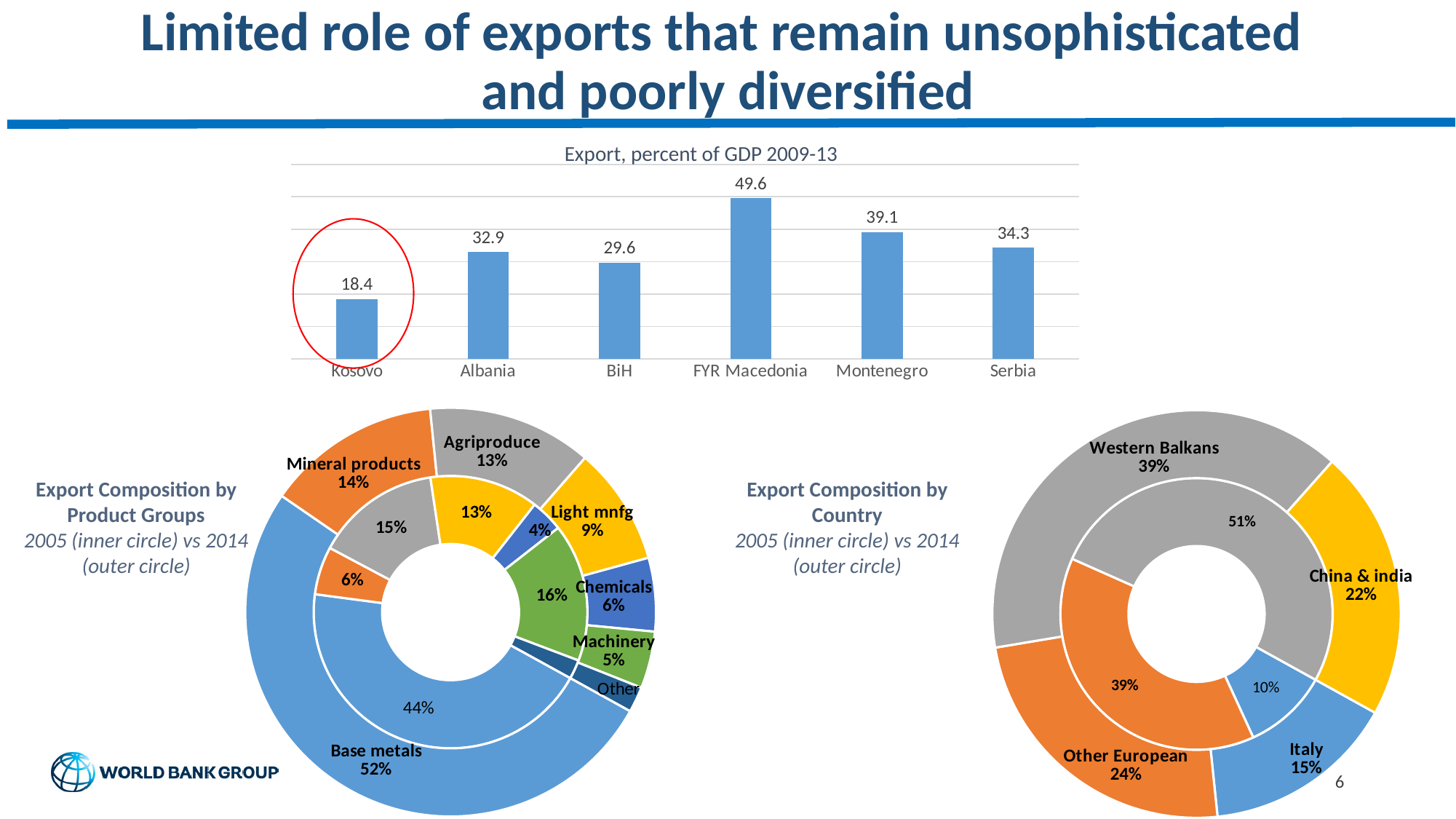
In the bar chart 'Export, percent of GDP 2009-13', what is the value for Kosovo? 18.4 In the 'Export Composition by Product Groups' chart, what share of the outer circle (2014) is Base metals? 52% How many countries are shown in the bar chart 'Export, percent of GDP 2009-13'? 6 In the 'Export Composition by Country' chart, what is the difference between the Western Balkans share in the inner circle (51%) and in the outer circle (39%)? 12% In the 'Export Composition by Product Groups' chart, what is the share of Mineral products in the outer circle (2014)? 14% In the bar chart 'Export, percent of GDP 2009-13', which country has the highest value? FYR Macedonia In the 'Export Composition by Country' chart, what share of the outer circle (2014) is China & india? 22% In the bar chart 'Export, percent of GDP 2009-13', which is larger, the value for Montenegro or the value for Serbia? Montenegro What kind of chart is 'Export, percent of GDP 2009-13'? Bar chart In the bar chart 'Export, percent of GDP 2009-13', what is the difference between the values for FYR Macedonia and Kosovo? 31.2 In the bar chart 'Export, percent of GDP 2009-13', which country has the lowest value? Kosovo In the 'Export Composition by Country' chart, which category has the largest share in the outer circle (2014)? Western Balkans